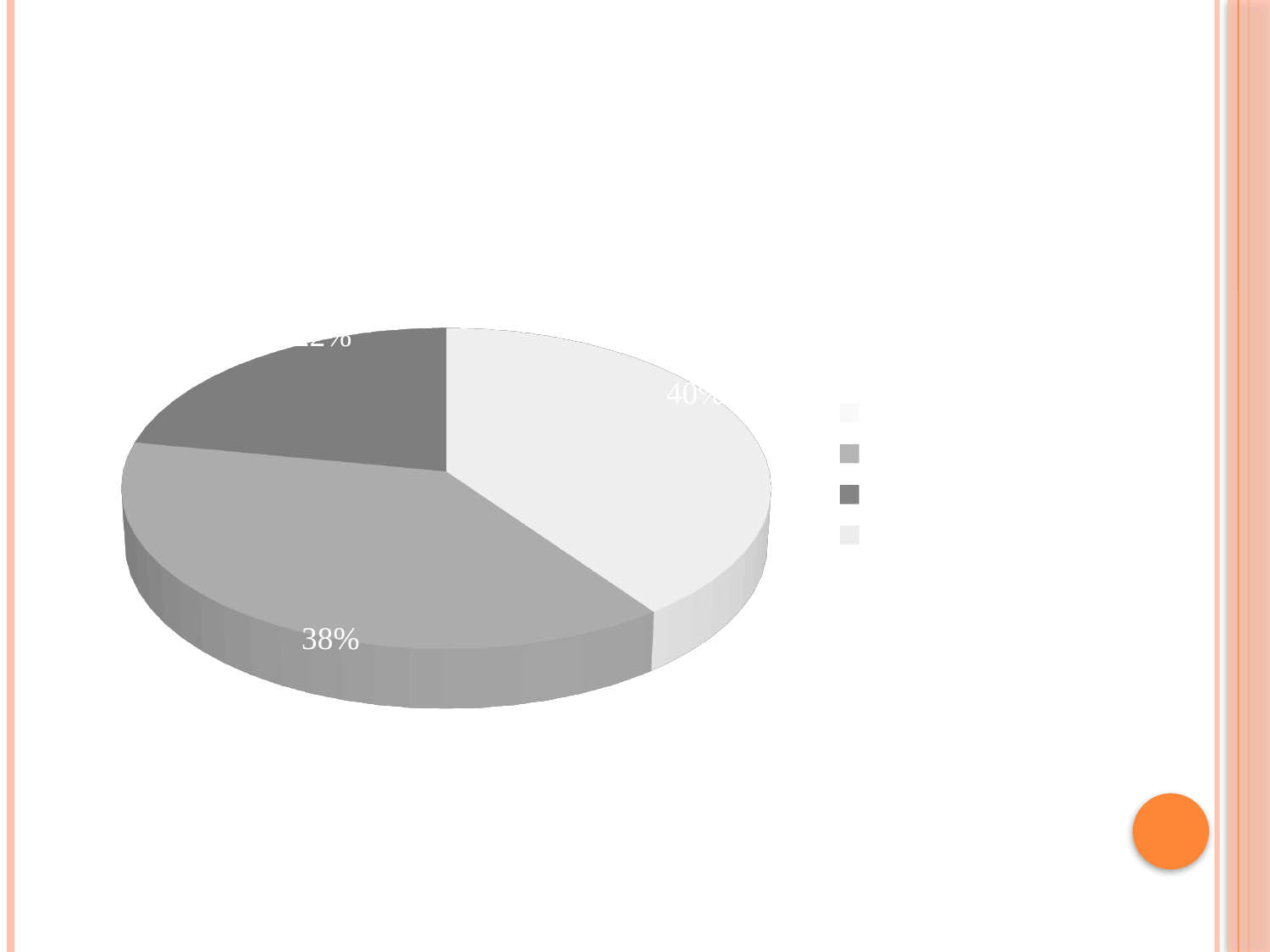
Which is larger, the light slice or the medium gray slice? the light slice (40%) Is the pie drawn in 3D or flat? 3D How many slices are visible in the pie? 3 What percentage is printed on the medium gray slice at the bottom left of the pie? 38% What percentage is printed on the lightest slice on the right side of the pie? 40% What kind of chart is shown on the slide? pie chart How many entries does the legend show? 4 Which slice of the pie is the largest? the light slice labelled 40% What is the difference between the 40% slice and the 38% slice? 2%